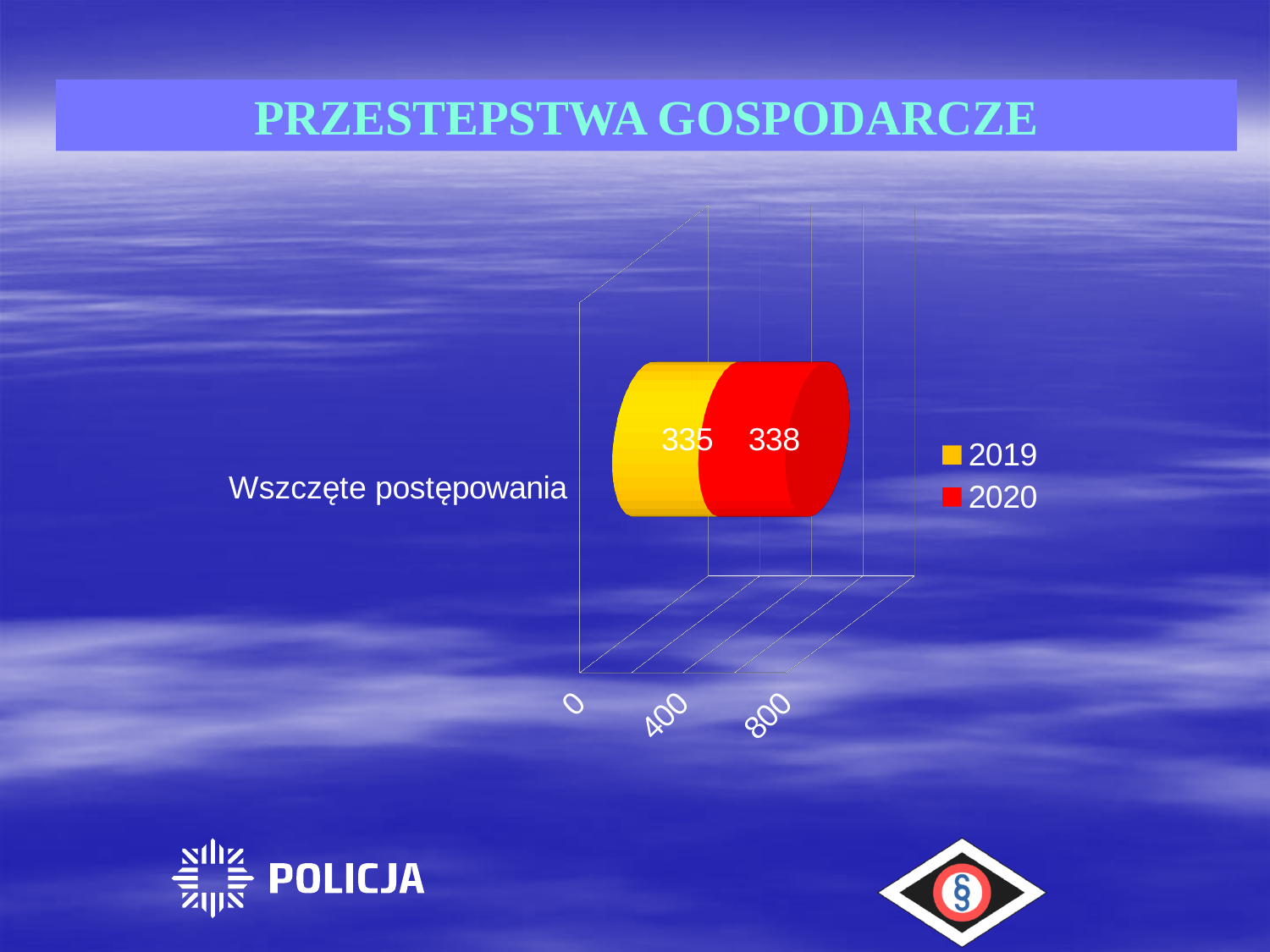
How many categories are shown on the chart? 1 Is the value for 2019 greater or less than 400? less Is the value for 2020 greater or less than 400? less What is the value for 2020 for Wszczęte postępowania? 338 What kind of chart is shown on the slide? bar chart Which series has the higher value for Wszczęte postępowania, 2019 or 2020? 2020 How many series does the legend list? 2 What is the value for 2019 for Wszczęte postępowania? 335 What is the highest tick value shown on the value axis? 800 What is the title of the slide? PRZESTEPSTWA GOSPODARCZE What is the difference between the 2020 and 2019 values for Wszczęte postępowania? 3 Which colour represents the 2020 series in the legend? red